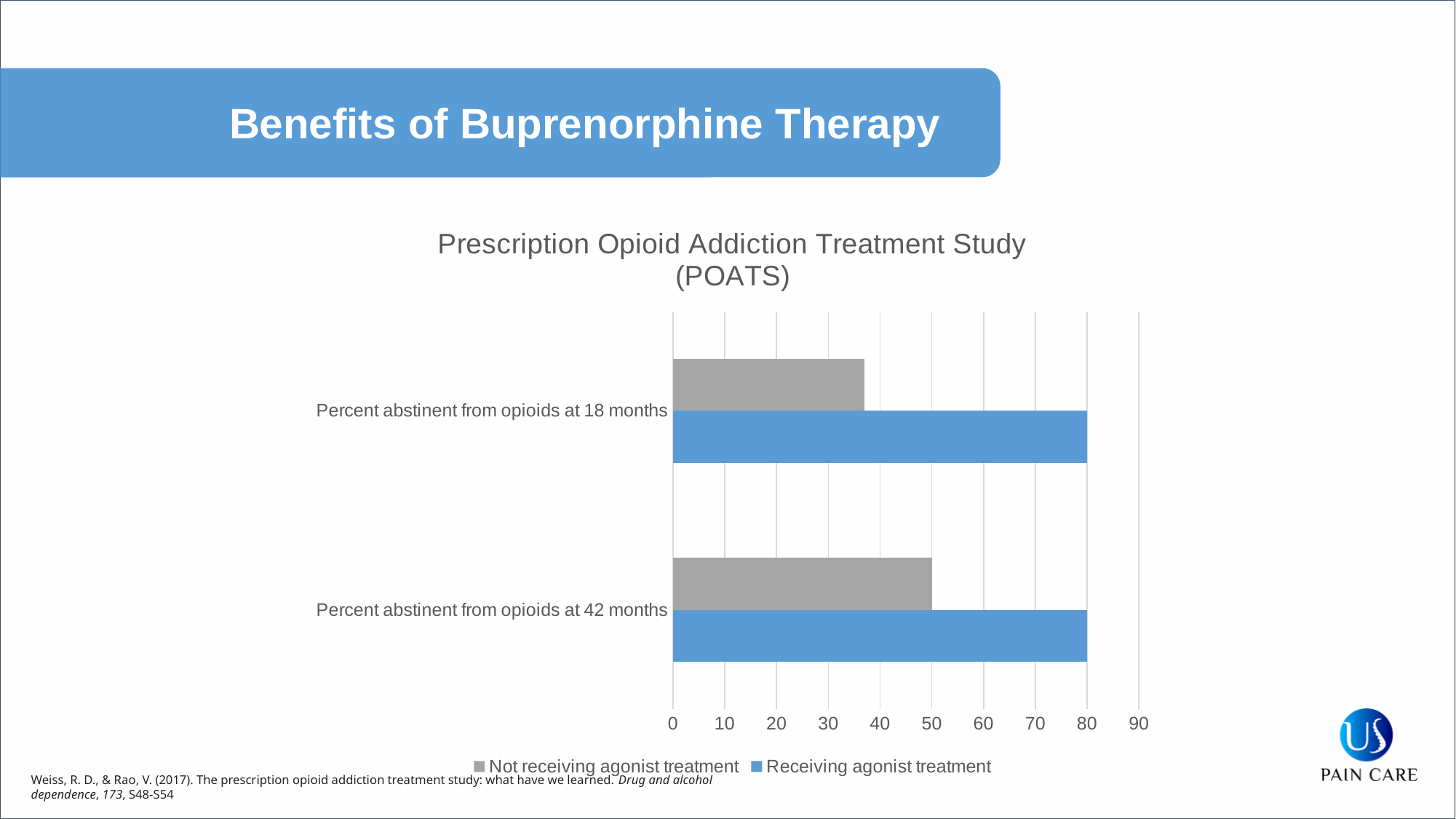
What is the value for Not receiving agonist treatment for Percent abstinent from opioids at 42 months? 50 How many series does the legend list? 2 Which colour represents the Not receiving agonist treatment series? grey What is the difference between Receiving agonist treatment and Not receiving agonist treatment for Percent abstinent from opioids at 42 months? 30 Which series has the larger value for Percent abstinent from opioids at 18 months? Receiving agonist treatment How many categories are shown on the chart? 2 Is the value for Not receiving agonist treatment at 18 months greater or less than 30? greater What kind of chart is shown on the slide? bar chart What is the value for Receiving agonist treatment for Percent abstinent from opioids at 42 months? 80 What is the title of the chart? Prescription Opioid Addiction Treatment Study (POATS) What is the value for Receiving agonist treatment for Percent abstinent from opioids at 18 months? 80 Is the value for Not receiving agonist treatment at 18 months greater or less than 40? less